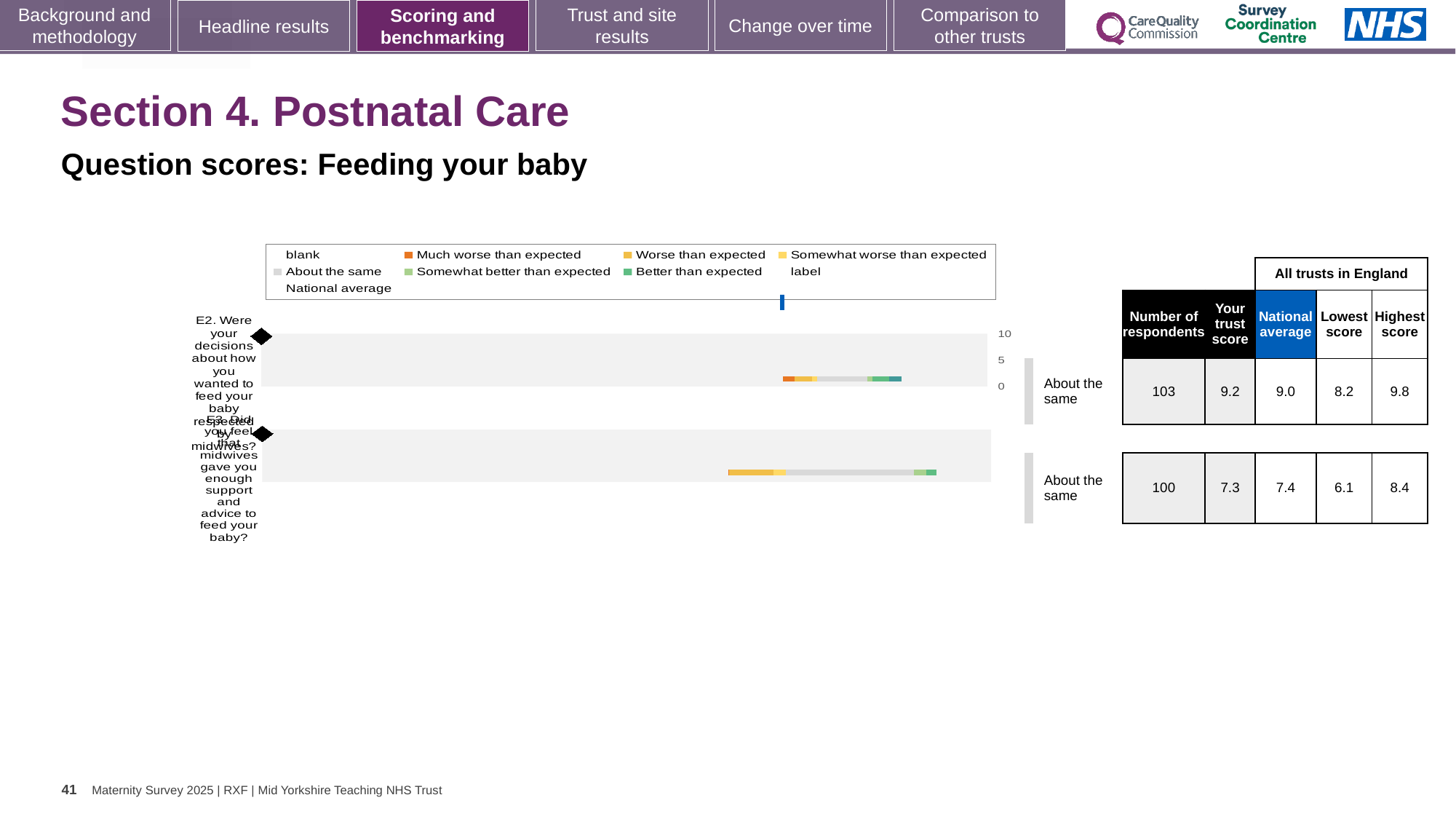
For question E2, which is larger: the trust score or the national average? Trust score What benchmark category is shown for question E2? About the same Which question has the higher trust score, E2 or E3? E2 What is the national average for question E3 (midwives gave you enough support and advice to feed your baby)? 7.4 What is the trust score for question E2 (decisions about how you wanted to feed your baby respected by midwives)? 9.2 What is the difference between the highest score and the lowest score for question E3? 2.3 How many questions (categories) are plotted in the chart? 2 How many respondents answered question E3? 100 What kind of chart is shown on the slide? Bar chart Which legend entry is shown in orange? Much worse than expected For question E3, which is larger: the trust score or the national average? National average What is the difference between the highest score and the lowest score for question E2? 1.6